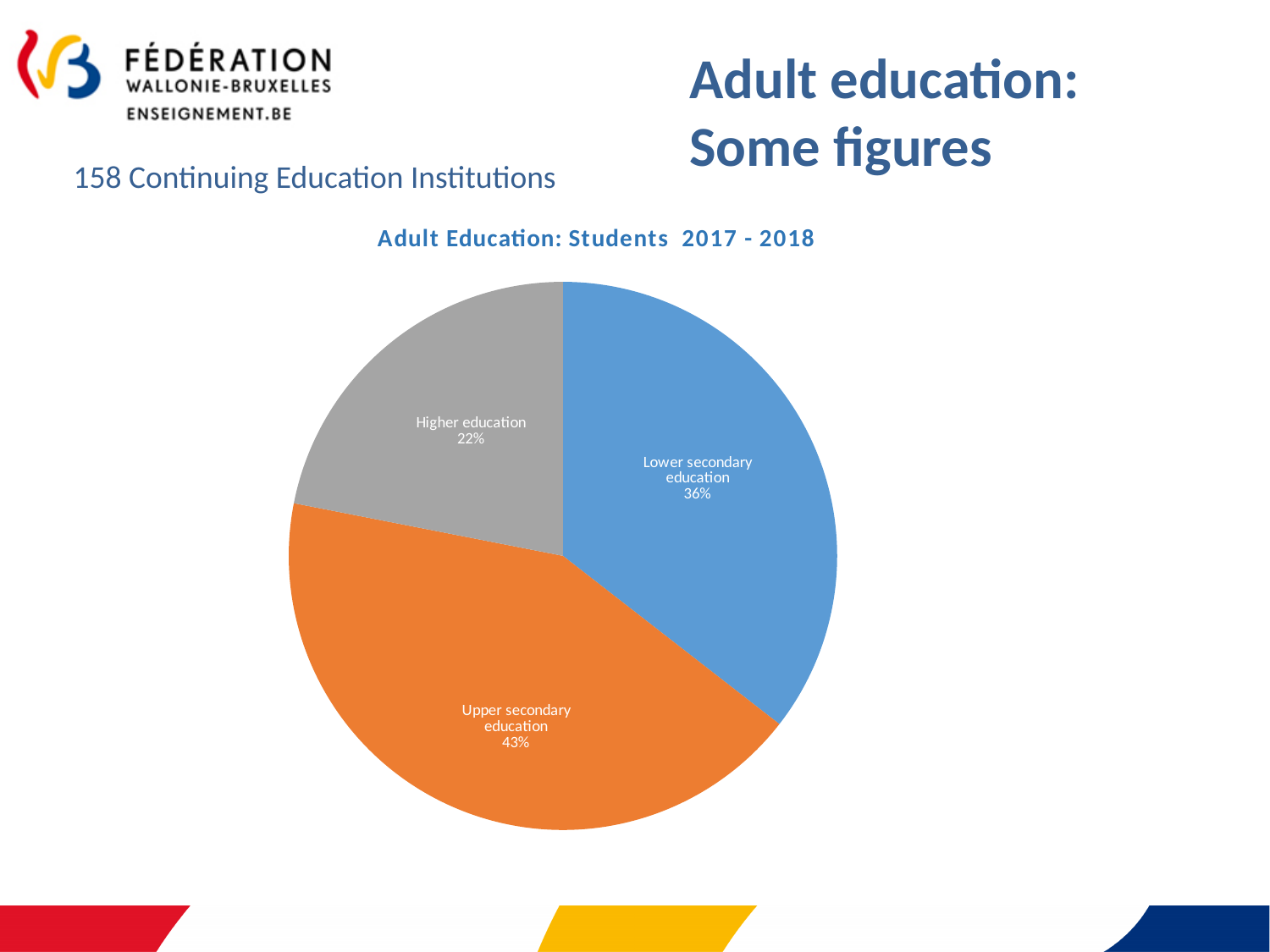
What is the difference in percentage points between Upper secondary education and Lower secondary education? 7 What type of chart is shown on the slide? pie chart What is the difference in percentage points between Upper secondary education and Higher education? 21 What colour is the Upper secondary education slice? orange What is the title of the chart? Adult Education: Students 2017 - 2018 What share of students is in Upper secondary education? 43% How many categories does the pie chart show? 3 What share of students is in Lower secondary education? 36% Which category has the smallest share of students? Higher education Which is larger, the share for Lower secondary education or the share for Higher education? Lower secondary education What share of students is in Higher education? 22% Which category has the largest share of students? Upper secondary education